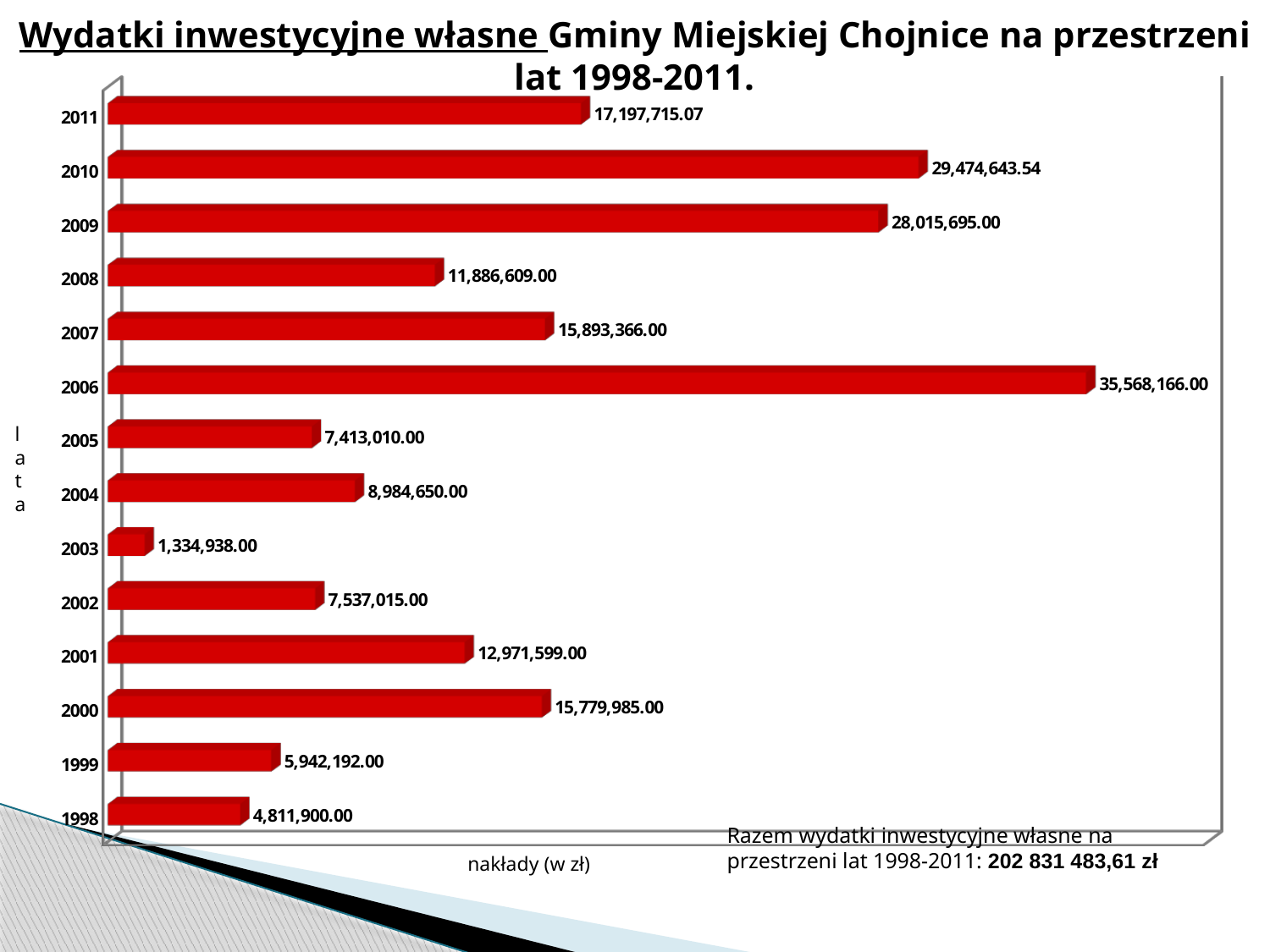
What is the difference between the 2010 and 2009 values? 1,458,948.54 Which year had the highest own investment expenditure? 2006 What was the value of own investment expenditure in 2011? 17,197,715.07 Which year had the lowest own investment expenditure? 2003 What was the value of own investment expenditure in 2006? 35,568,166.00 How many years are shown in the chart? 14 Which year had a larger value, 2001 or 2008? 2001 Which year had a larger value, 2002 or 2005? 2002 What was the value of own investment expenditure in 1998? 4,811,900.00 What is the difference between the 2007 and 2000 values? 113,381.00 What is the label of the horizontal axis of the chart? nakłady (w zł) What kind of chart is shown on the slide? Bar chart